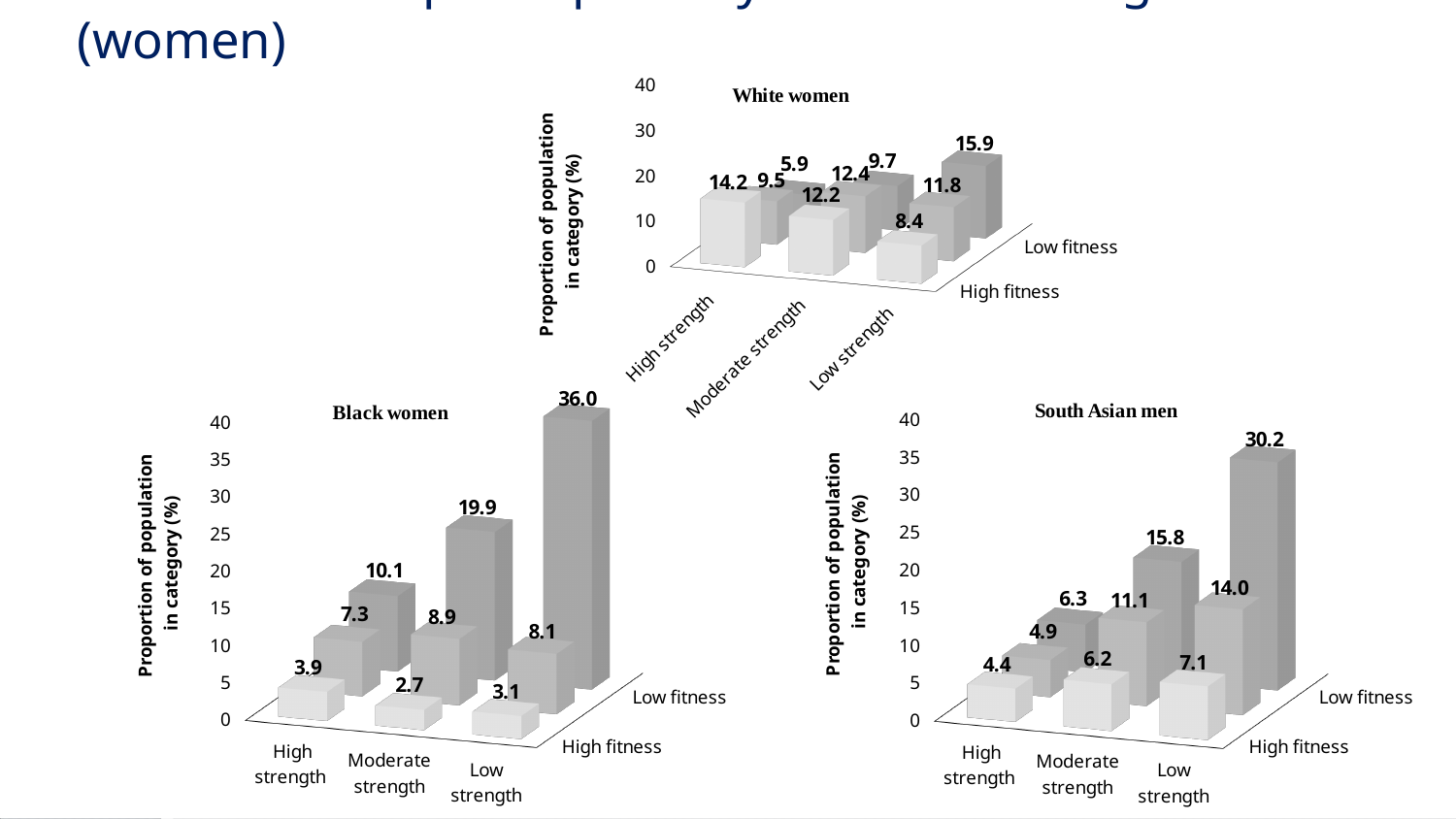
What kind of chart is the Black women chart? Bar chart In the South Asian men chart, what is the difference between the Low fitness values for Low strength and Moderate strength? 14.4 In the Black women chart, what is the difference between the Low fitness values for Low strength and High strength? 25.9 In the Black women chart, which strength and fitness combination has the lowest value? Moderate strength, High fitness In the Black women chart, what is the value for Low strength at Low fitness? 36.0 In the South Asian men chart, what is the value for Low strength at Low fitness? 30.2 In the Black women chart, do the Low fitness values rise or fall going from High strength to Low strength? Rise In the South Asian men chart, at High fitness, which is larger: Low strength or High strength? Low strength How many charts are shown on the slide? 3 In the White women chart, what is the value for High strength at High fitness? 14.2 In the White women chart, what is the value for Low strength at Low fitness? 15.9 In the Black women chart, which strength and fitness combination has the highest value? Low strength, Low fitness